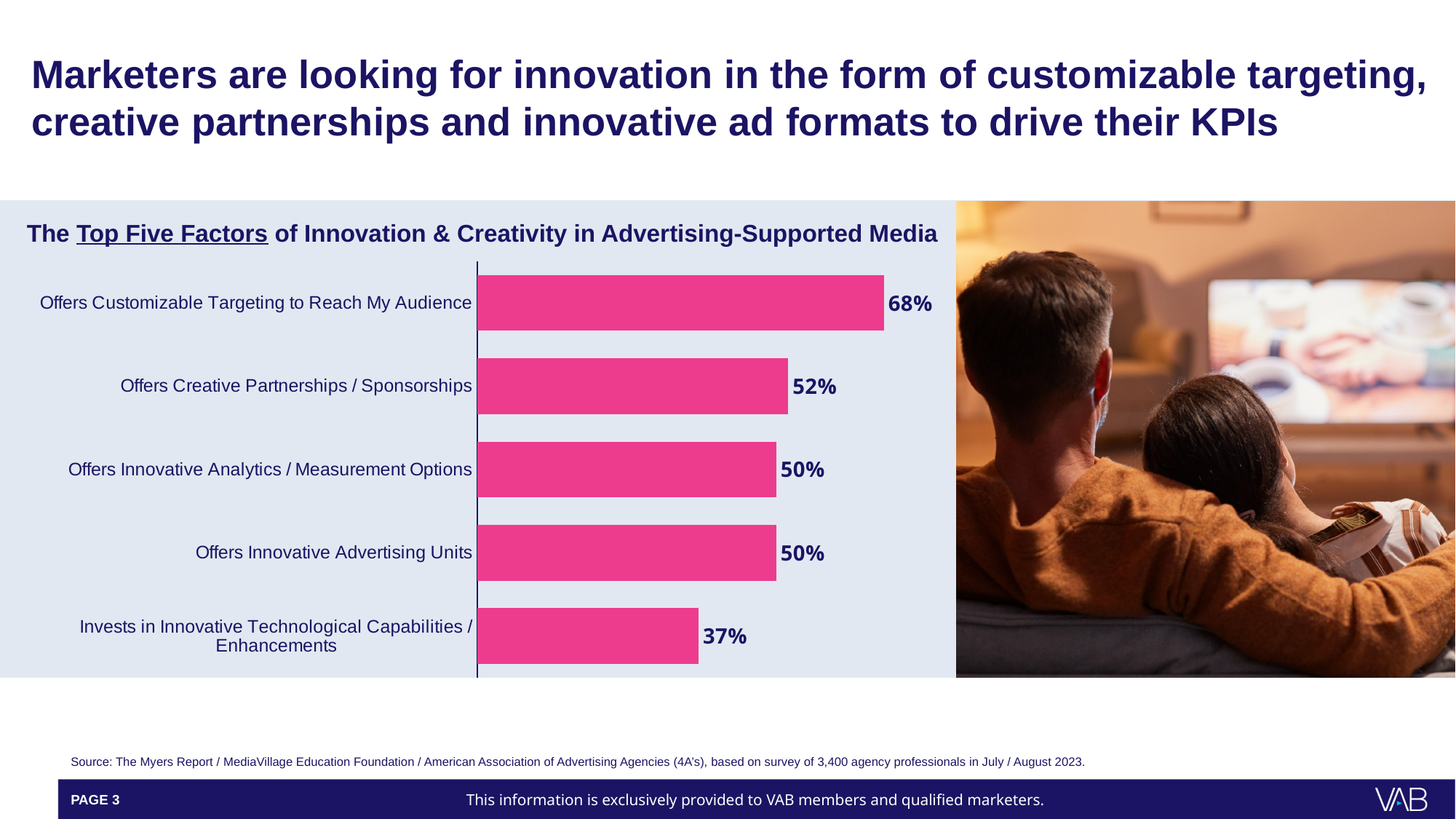
Which factor has the highest percentage? Offers Customizable Targeting to Reach My Audience What is the title of the chart? The Top Five Factors of Innovation & Creativity in Advertising-Supported Media How many factors are plotted in the chart? 5 Which factor has the lowest percentage? Invests in Innovative Technological Capabilities / Enhancements What percentage is shown for "Offers Customizable Targeting to Reach My Audience"? 68% What percentage is shown for "Invests in Innovative Technological Capabilities / Enhancements"? 37% What is the difference between the values for "Offers Customizable Targeting to Reach My Audience" and "Offers Creative Partnerships / Sponsorships"? 16% What kind of chart is shown on the slide? Bar chart What value is shown for "Offers Innovative Advertising Units"? 50% What value is shown for "Offers Creative Partnerships / Sponsorships"? 52% What is the difference between the values for "Offers Innovative Analytics / Measurement Options" and "Invests in Innovative Technological Capabilities / Enhancements"? 13% Which is larger: the value for "Offers Creative Partnerships / Sponsorships" or the value for "Invests in Innovative Technological Capabilities / Enhancements"? Offers Creative Partnerships / Sponsorships